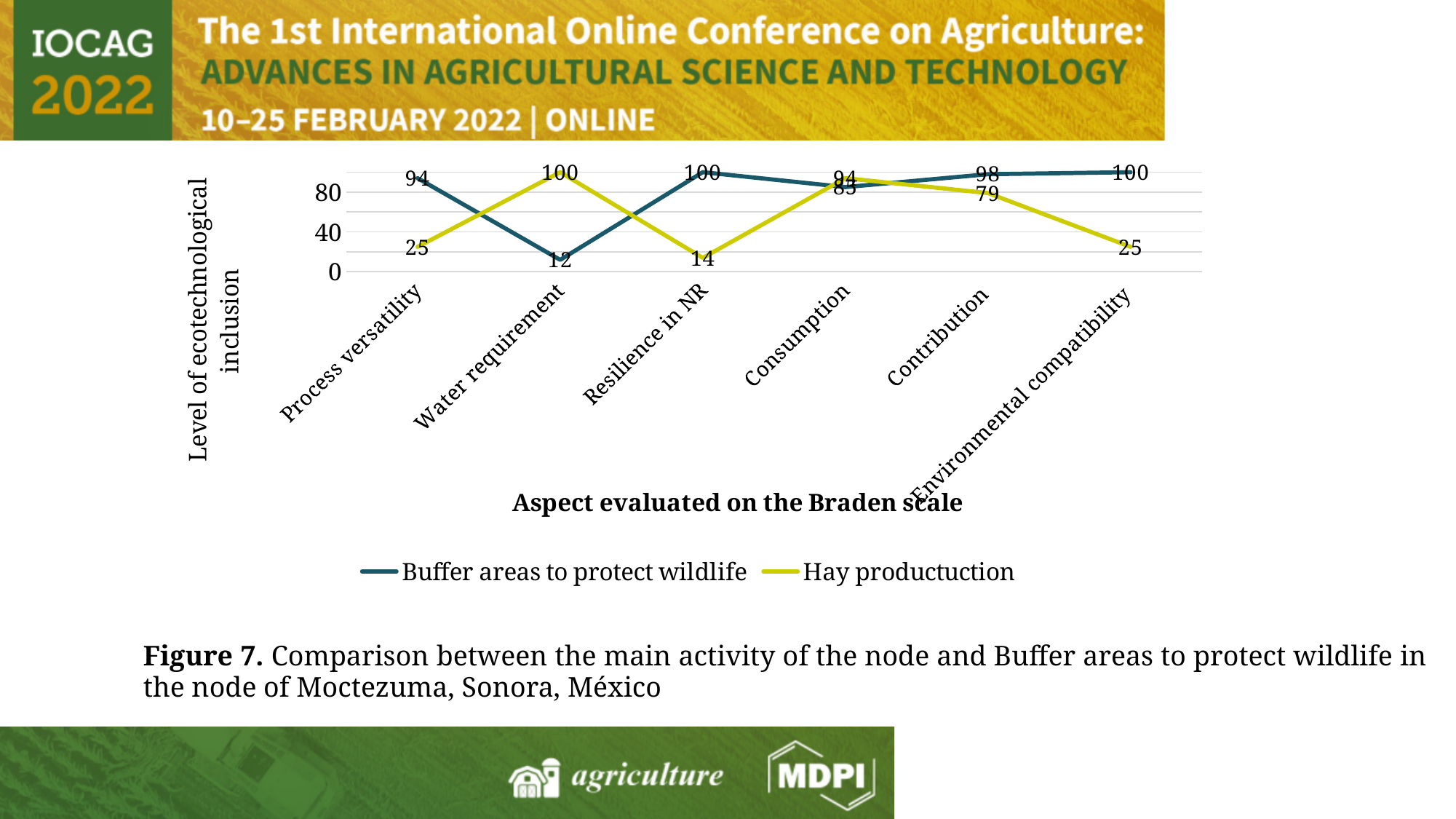
What is the value for Buffer areas to protect wildlife at Water requirement? 12 What is the value for Hay productuction at Consumption? 94 What type of chart is shown on the slide? Line chart How many series does the legend list? 2 What is the value for Hay productuction at Contribution? 79 What is the title of the x axis? Aspect evaluated on the Braden scale Is the value for Hay productuction at Environmental compatibility greater or less than 40? less How many aspects are plotted along the x axis? 6 Which aspect has the highest value for Hay productuction? Water requirement What is the difference between Buffer areas to protect wildlife and Hay productuction at Resilience in NR? 86 At Process versatility, which series has the larger value? Buffer areas to protect wildlife Which aspect has the lowest value for Buffer areas to protect wildlife? Water requirement